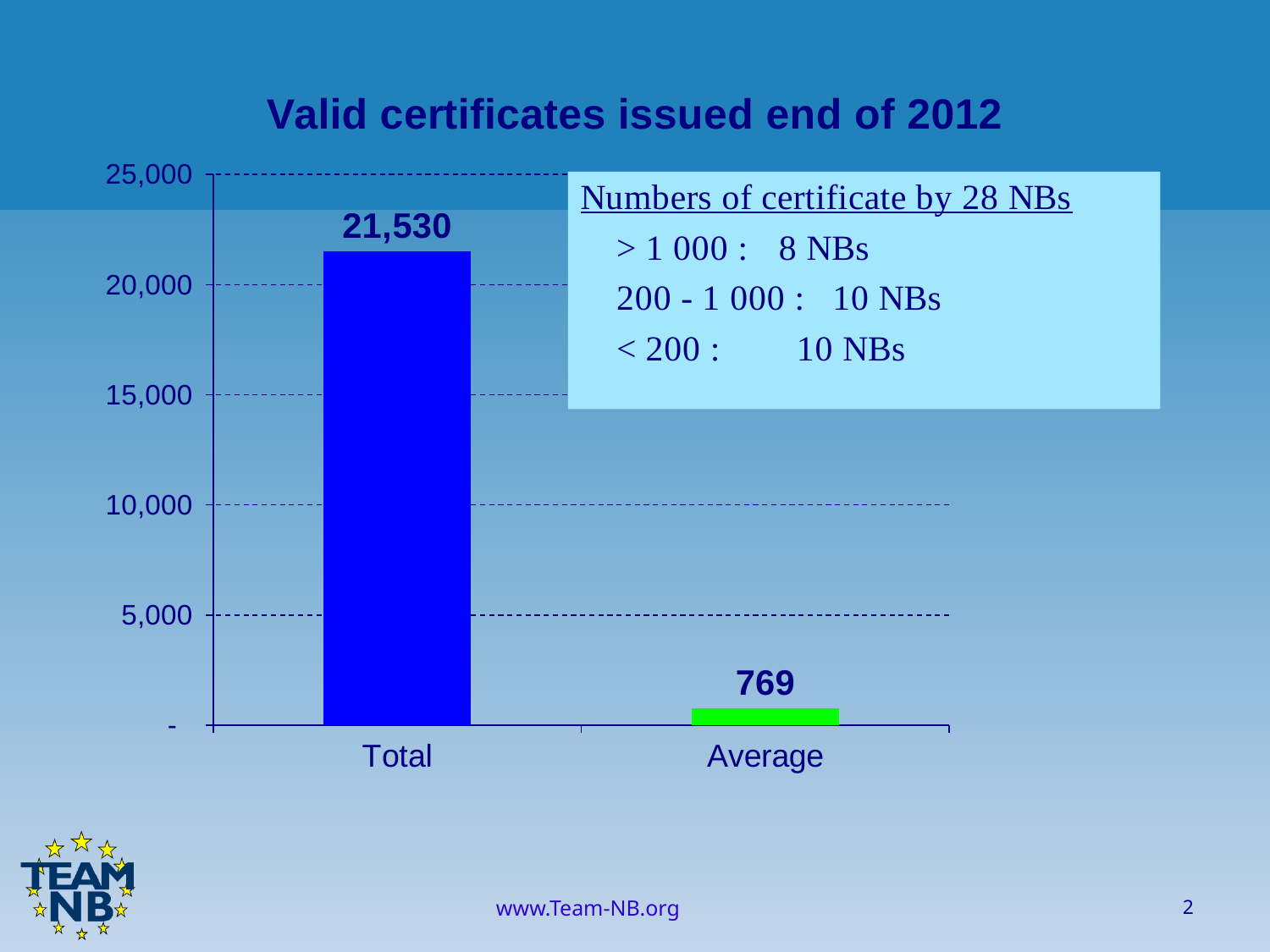
What is the value for Total? 21,530 What is the title of the chart? Valid certificates issued end of 2012 What colour is the bar for Average? green What is the value for Average? 769 Which is larger, the value for Total or the value for Average? Total Which category has the highest value? Total Is the value for Total greater or less than 20,000? greater What is the difference between the Total and Average values? 20,761 What kind of chart is shown on the slide? bar chart Which category has the lowest value? Average Is the value for Average greater or less than 5,000? less How many categories are shown on the x axis? 2